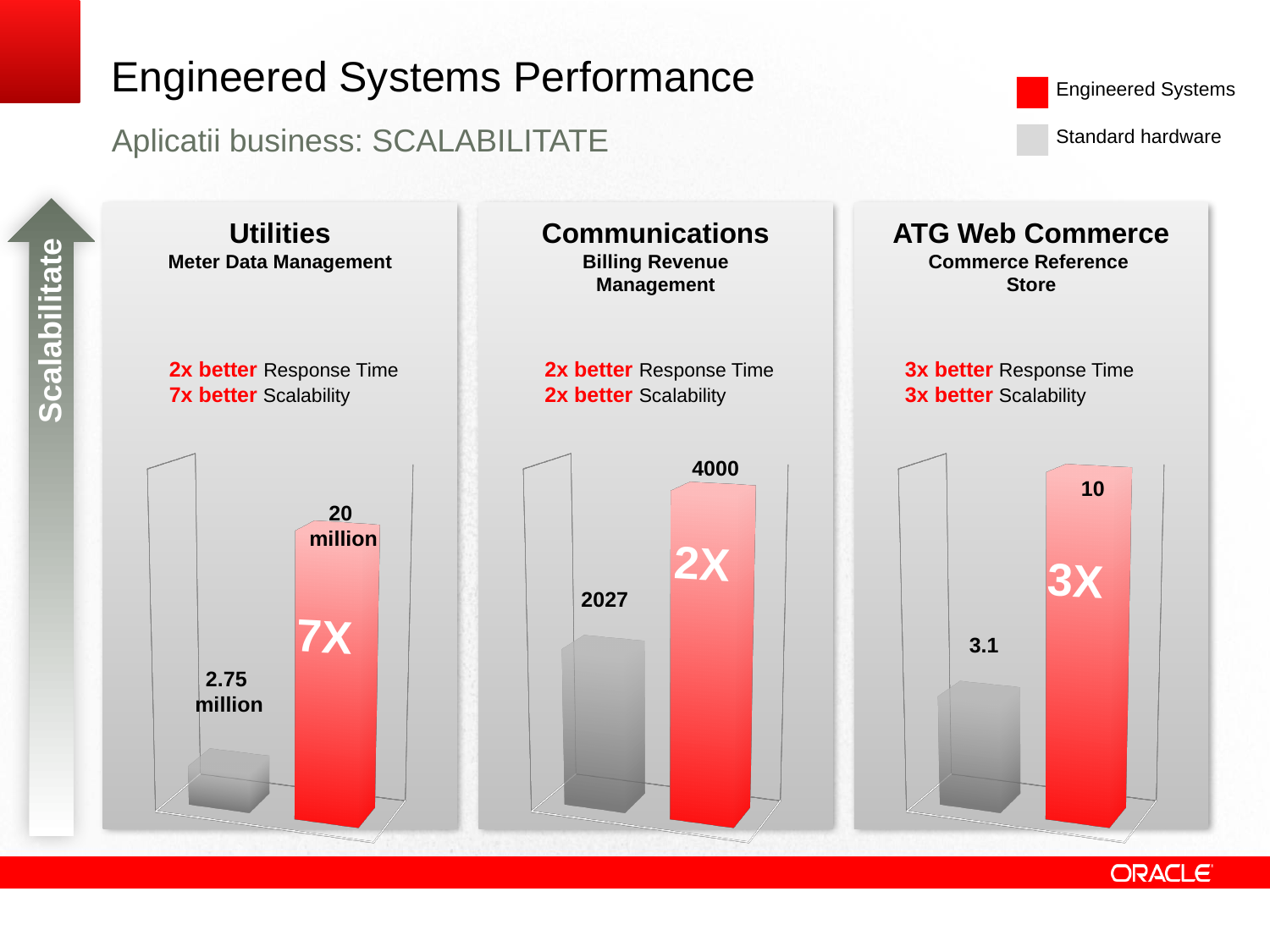
How many bars are plotted in the Communications chart? 2 In the Utilities chart, what value is shown for Engineered Systems? 20 million In the Utilities chart, which bar is taller, Engineered Systems or Standard hardware? Engineered Systems According to the legend, which colour represents Standard hardware? Grey In the Communications chart, what value is shown for Standard hardware? 2027 In the Communications chart, what value is shown for Engineered Systems? 4000 In the ATG Web Commerce chart, what is the difference between the Engineered Systems value and the Standard hardware value? 6.9 In the Utilities chart, what value is shown for Standard hardware? 2.75 million In the ATG Web Commerce chart, what value is shown for Engineered Systems? 10 In the Communications chart, what is the difference between the Engineered Systems value and the Standard hardware value? 1973 What type of chart is used in the ATG Web Commerce panel? Bar chart In the ATG Web Commerce chart, what value is shown for Standard hardware? 3.1